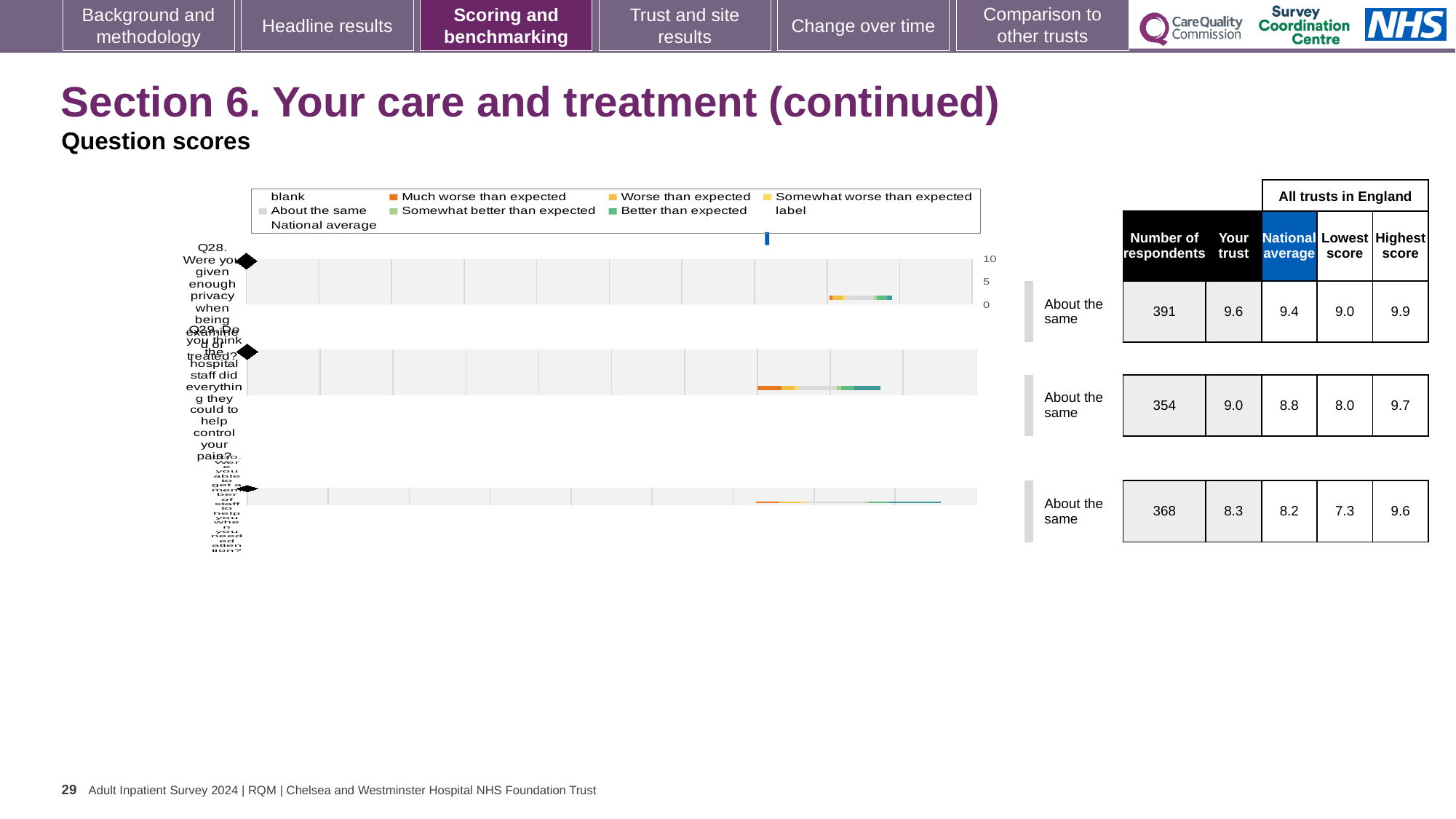
Which question has the lowest 'Lowest score' value among all trusts in England? Q30 Which question has the highest 'Your trust' score on this slide? Q28 How many respondents answered Q30? 368 For Q29, which is larger: the 'Your trust' score or the national average? Your trust What is the national average score for Q29 (Do you think the hospital staff did everything they could to help control your pain?)? 8.8 What kind of chart is used to show the question scores? Bar chart Which legend entry is shown in orange? Much worse than expected What is the difference between the highest score and the lowest score for Q30? 2.3 What is the 'Your trust' score for Q28 (Were you given enough privacy when being examined or treated?)? 9.6 What is the highest score among all trusts in England for Q28? 9.9 What is the difference between the 'Your trust' score and the national average for Q28? 0.2 How many questions are plotted on this slide? 3